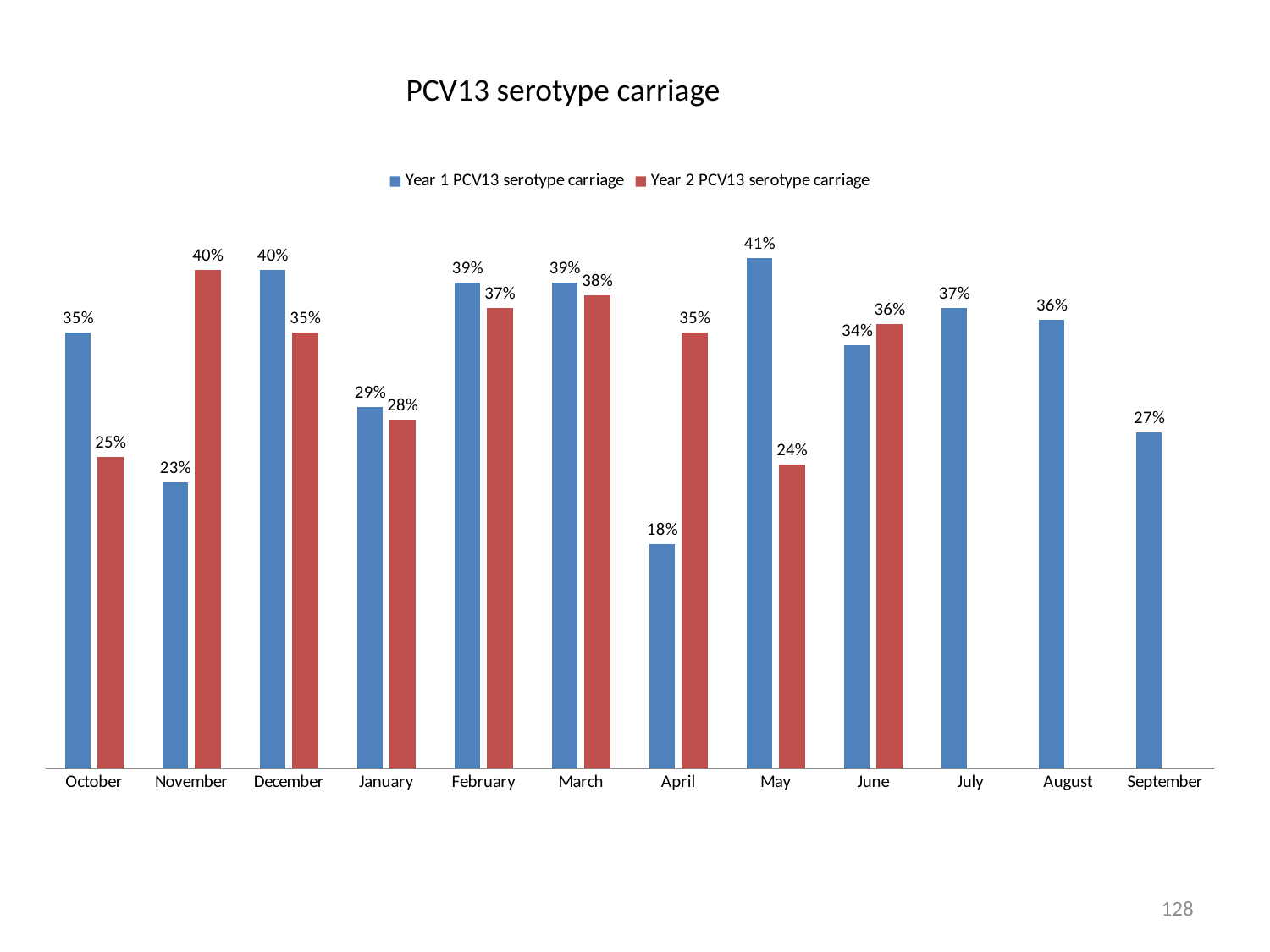
How many series does the legend list? 2 What is the difference between the Year 2 and Year 1 PCV13 serotype carriage values for April? 17% What is the Year 1 PCV13 serotype carriage value for April? 18% Which month has the highest Year 1 PCV13 serotype carriage? May What is the title of the chart? PCV13 serotype carriage How many months are shown on the x axis? 12 What is the Year 2 PCV13 serotype carriage value for November? 40% Which month has the lowest Year 2 PCV13 serotype carriage? May What is the Year 1 PCV13 serotype carriage value for October? 35% Which is larger for November: Year 1 or Year 2 PCV13 serotype carriage? Year 2 PCV13 serotype carriage What kind of chart is shown on the slide? Bar chart Which month has the lowest Year 1 PCV13 serotype carriage? April